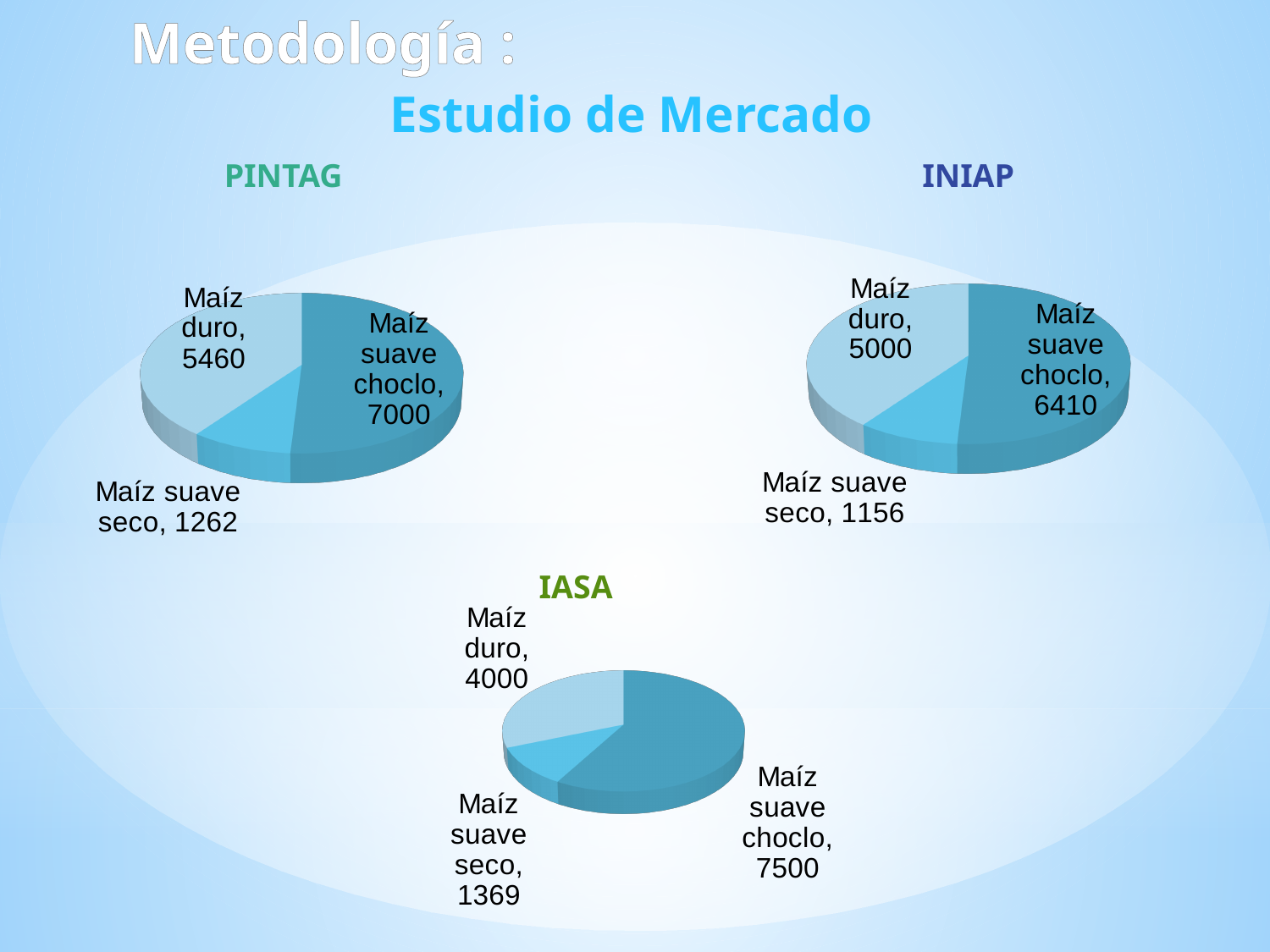
How many slices does the INIAP pie chart have? 3 How many pie charts are shown on the slide? 3 In the INIAP chart, what is the difference between Maíz suave choclo and Maíz duro? 1410 In the PINTAG chart, which category has the smallest slice? Maíz suave seco In the IASA chart, what is the value for Maíz suave seco? 1369 What type of chart is used for IASA? Pie chart In the PINTAG chart, what is the difference between Maíz duro and Maíz suave seco? 4198 In the PINTAG chart, what is the value for Maíz suave choclo? 7000 In the INIAP chart, what is the value for Maíz duro? 5000 In the IASA chart, which category has the largest slice? Maíz suave choclo Which is larger: Maíz suave choclo in the IASA chart or Maíz suave choclo in the PINTAG chart? IASA In the INIAP chart, what is the total of all three slices? 12566